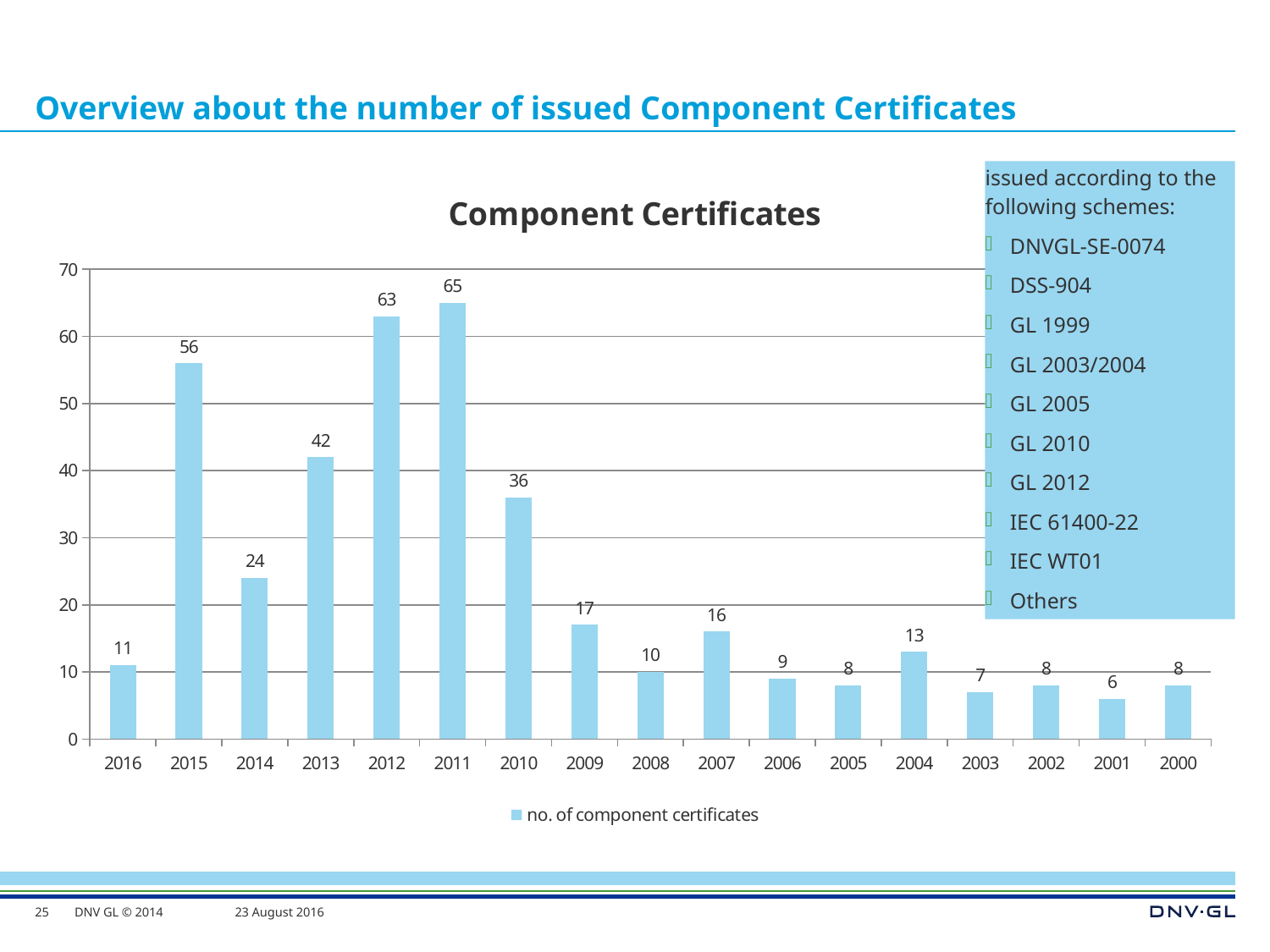
What kind of chart is shown on the slide? bar chart What is the number of component certificates for 2016? 11 Which year has the lowest number of component certificates? 2001 What is the legend entry of the chart? no. of component certificates How many years are shown on the x axis of the chart? 17 What is the number of component certificates for 2004? 13 How many series does the legend list? 1 Which year has more component certificates, 2010 or 2009? 2010 What is the difference between the number of component certificates in 2015 and 2014? 32 Which year has the highest number of component certificates? 2011 What is the number of component certificates for 2012? 63 What is the title of the chart? Component Certificates